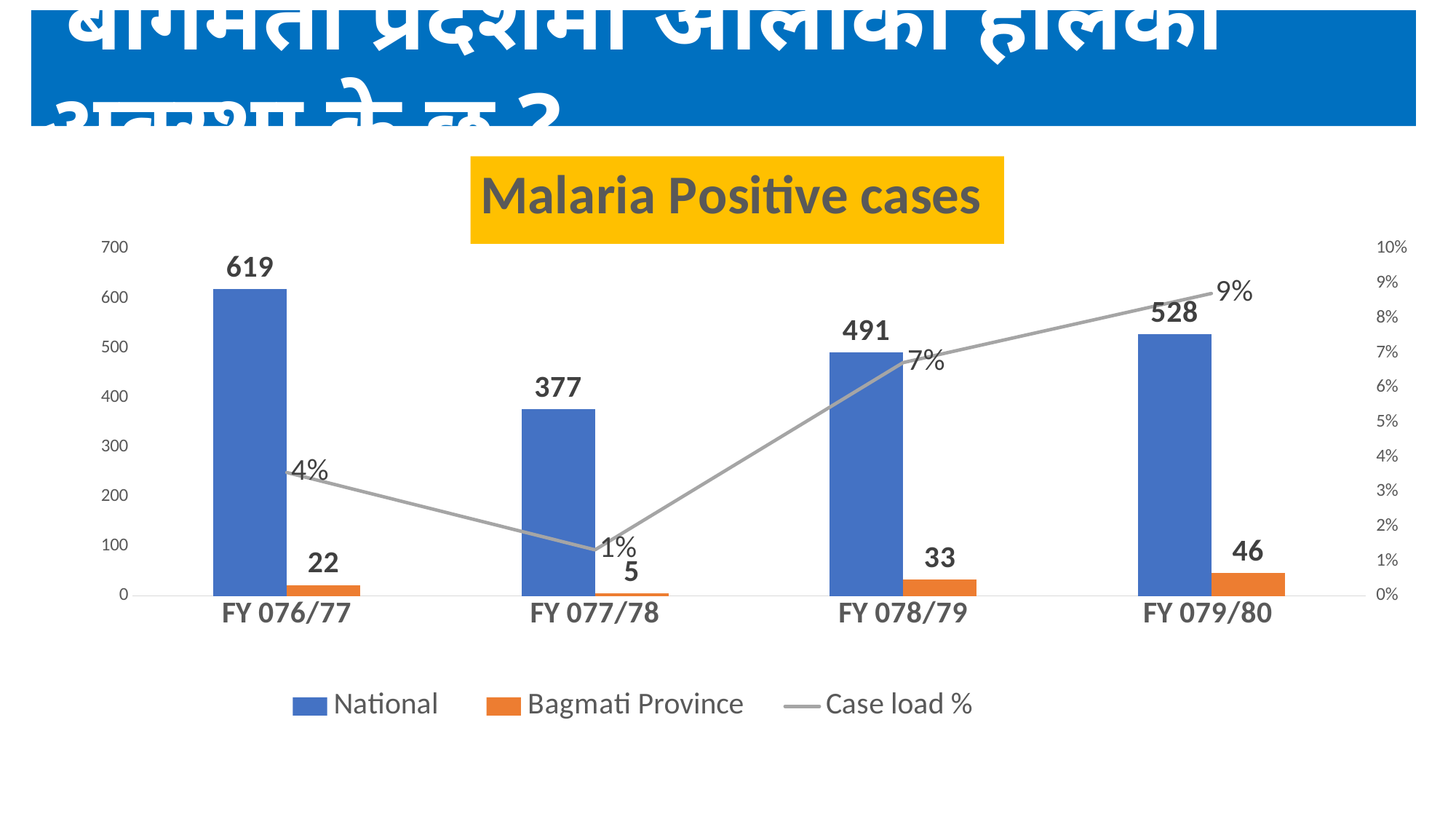
Does the Case load % rise or fall from FY 077/78 to FY 079/80? Rise What kind of chart is this? Combined bar and line chart What is the difference between the National values for FY 076/77 and FY 077/78? 242 What is the Bagmati Province value for FY 079/80? 46 What is the Case load % for FY 078/79? 7% Which fiscal year has the highest National value? FY 076/77 What is the title of the chart? Malaria Positive cases Which is larger, the Bagmati Province value for FY 078/79 or for FY 079/80? FY 079/80 Which fiscal year has the lowest Bagmati Province value? FY 077/78 How many fiscal years are shown on the x axis? 4 What is the National value for FY 076/77? 619 How many series does the legend list? 3